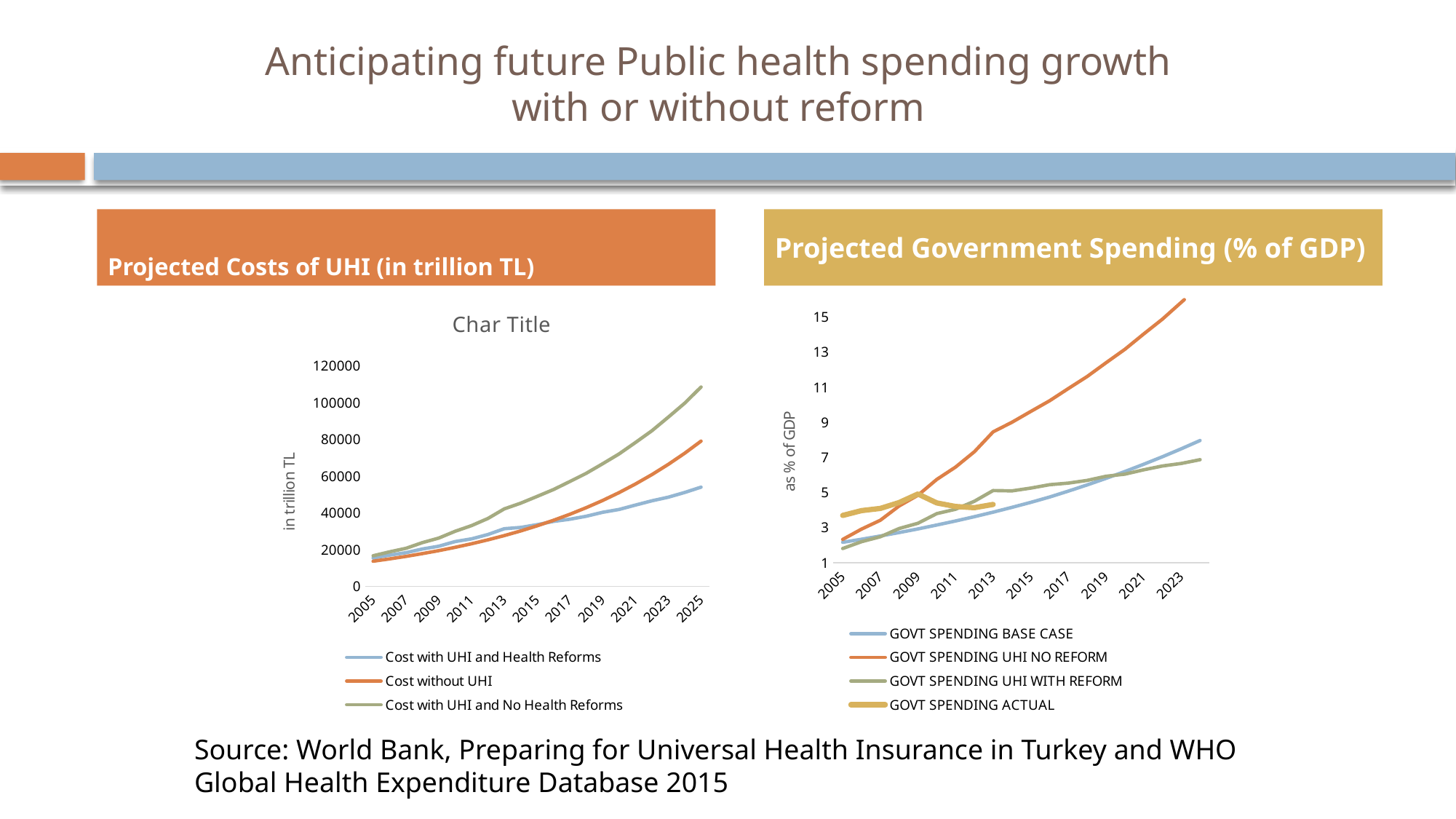
In the left chart, 'Projected Costs of UHI (in trillion TL)', which series has the highest value in 2025? Cost with UHI and No Health Reforms How many series does the legend of the right chart, 'Projected Government Spending (% of GDP)', list? 4 In the right chart, 'Projected Government Spending (% of GDP)', is the 2023 value for 'GOVT SPENDING UHI NO REFORM' greater or less than 15? greater What is the y-axis label of the right chart, 'Projected Government Spending (% of GDP)'? as % of GDP How many series does the legend of the left chart, 'Projected Costs of UHI (in trillion TL)', list? 3 In the right chart, 'Projected Government Spending (% of GDP)', does the 'GOVT SPENDING UHI NO REFORM' series rise or fall from 2005 to 2023? rise In the left chart, 'Projected Costs of UHI (in trillion TL)', which series has the lowest value in 2025? Cost with UHI and Health Reforms In the right chart, 'Projected Government Spending (% of GDP)', is the 2023 value for 'GOVT SPENDING BASE CASE' greater or less than 7? greater In the right chart, 'Projected Government Spending (% of GDP)', which series has the highest value in 2023? GOVT SPENDING UHI NO REFORM In the left chart, 'Projected Costs of UHI (in trillion TL)', is the 2025 value for 'Cost with UHI and No Health Reforms' greater or less than 100000? greater What kind of chart is the 'Projected Costs of UHI (in trillion TL)' chart on the left? line chart